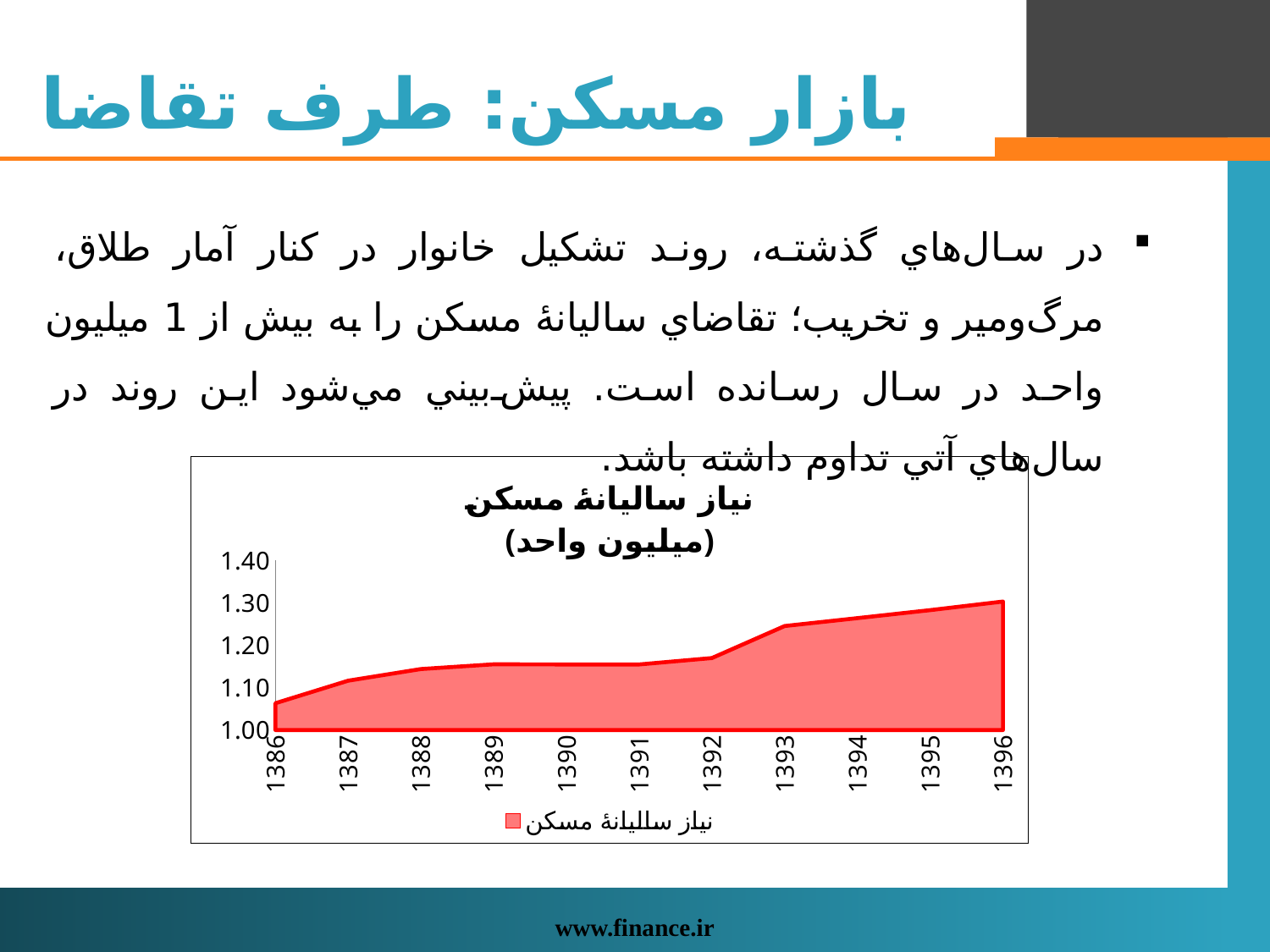
Which year has the larger value, 1392 or 1393? 1393 Is the value for 1393 greater or less than 1.20? greater What is the title of the chart? نياز ساليانۀ مسکن (ميليون واحد) Which year has the lowest value in the chart? 1386 What is the first year shown on the x axis of the chart? 1386 How many years are shown on the x axis of the chart? 11 Is the value for 1391 greater or less than 1.20? less Is the value for 1386 greater or less than 1.10? less Which year has the highest value in the chart? 1396 How many series does the chart legend list? 1 What kind of chart is shown on the slide? area chart Do the values generally rise or fall from 1386 to 1396? rise